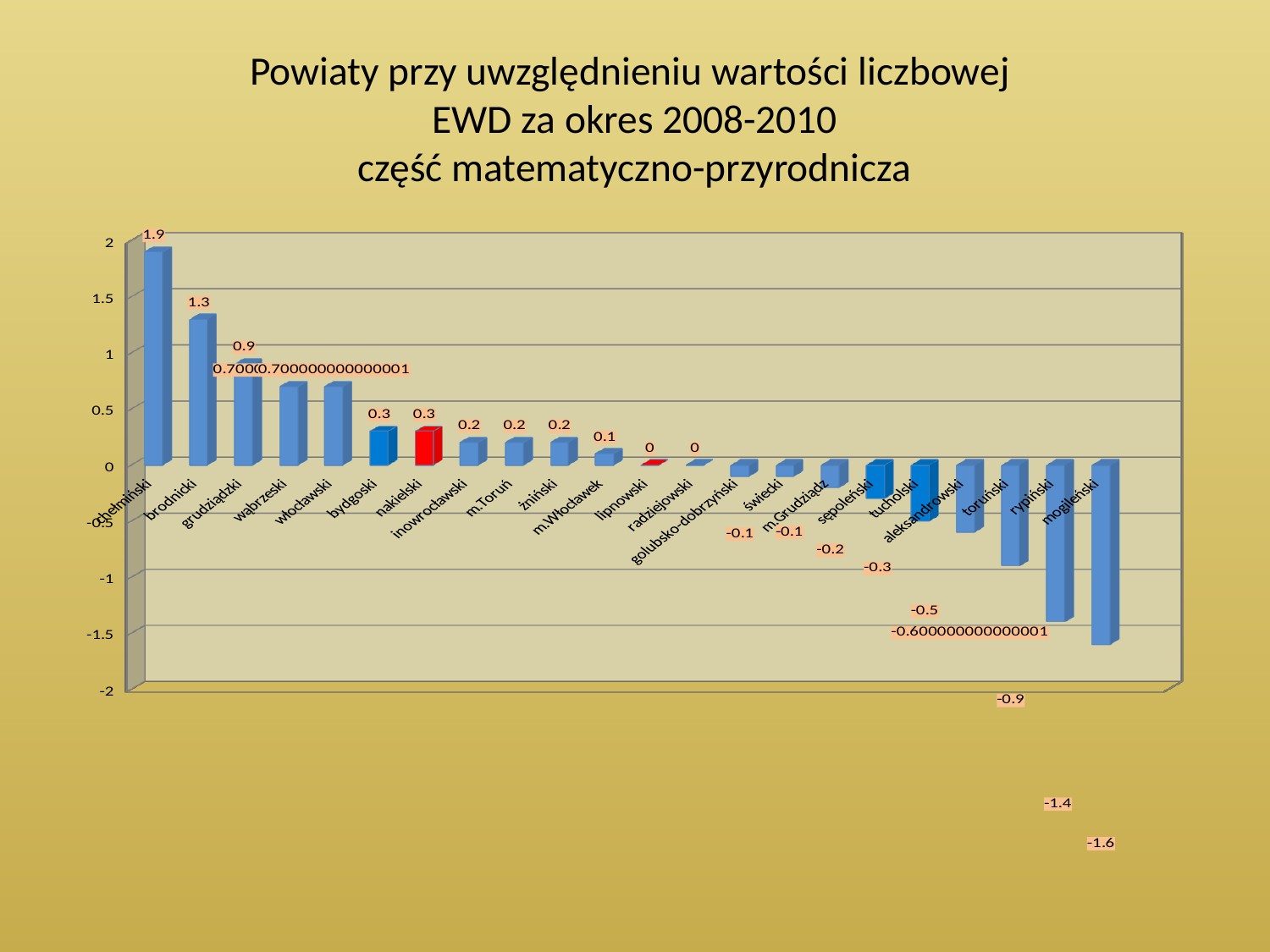
What is the value for brodnicki? 1.3 What is the value for rypiński? -1.4 Which has the larger value, grudziądzki or bydgoski? grudziądzki What is the value for mogileński? -1.6 What is the value for chełmiński? 1.9 How many powiats are shown on the chart? 22 Do the values rise or fall from left to right along the x axis? fall What is the difference between the values for chełmiński and brodnicki? 0.6 Is the value for toruński greater or less than -0.5? less What kind of chart is shown on the slide? bar chart Which powiat has the highest value? chełmiński Which powiat has the lowest value? mogileński